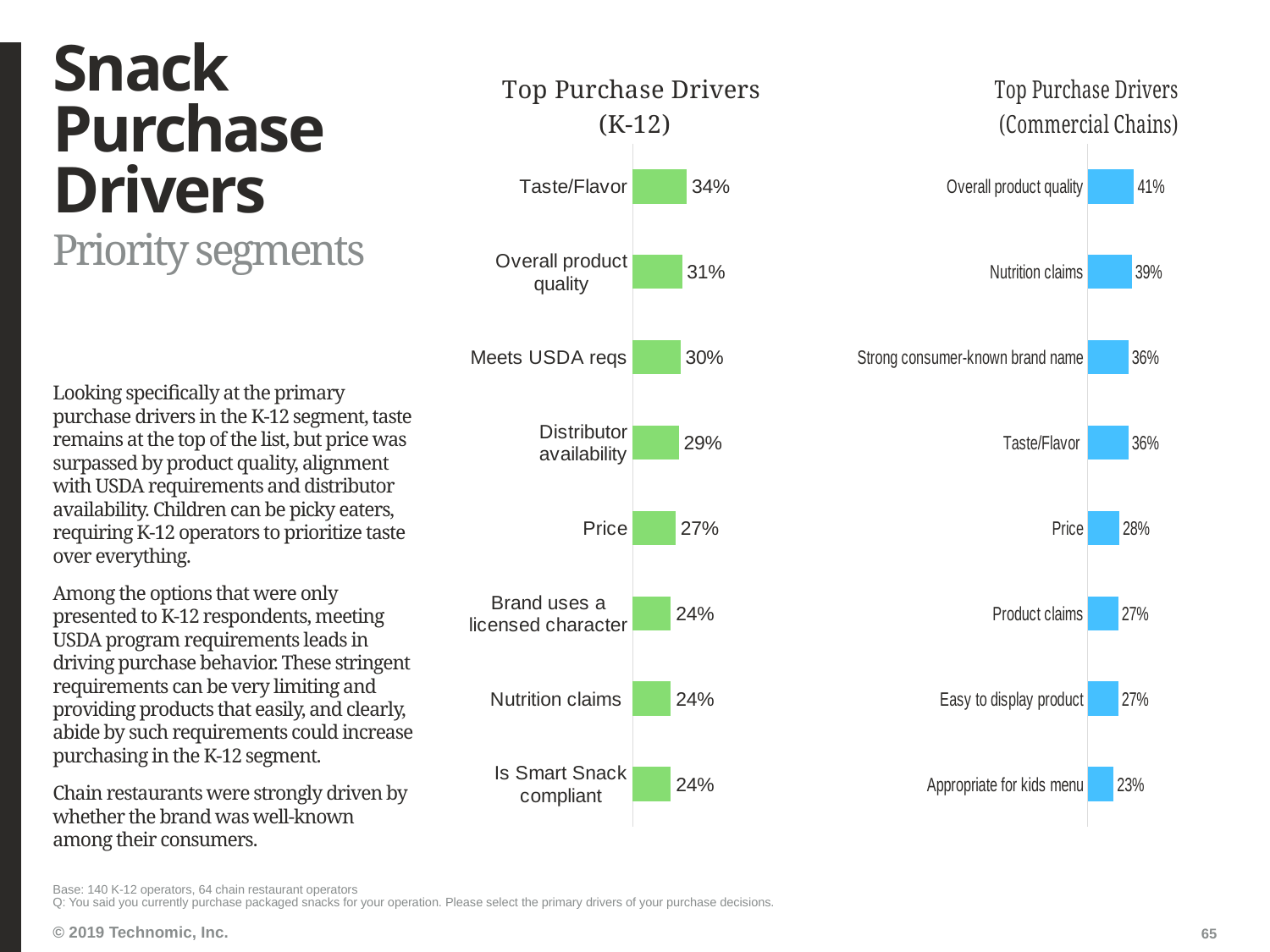
In the Top Purchase Drivers (Commercial Chains) chart, what is the value for Nutrition claims? 39% In the Top Purchase Drivers (K-12) chart, what is the difference between Taste/Flavor and Price? 7% In the Top Purchase Drivers (K-12) chart, which category has the highest value? Taste/Flavor In the Top Purchase Drivers (K-12) chart, which is larger: Overall product quality or Meets USDA reqs? Overall product quality In the Top Purchase Drivers (K-12) chart, what is the value for Taste/Flavor? 34% In the Top Purchase Drivers (Commercial Chains) chart, which category has the highest value? Overall product quality How many categories are shown in the Top Purchase Drivers (K-12) chart? 8 What type of chart is the Top Purchase Drivers (Commercial Chains) chart? Bar chart In the Top Purchase Drivers (Commercial Chains) chart, which category has the lowest value? Appropriate for kids menu In the Top Purchase Drivers (Commercial Chains) chart, what is the difference between Overall product quality and Price? 13% In the Top Purchase Drivers (K-12) chart, what is the value for Distributor availability? 29% What colour are the bars in the Top Purchase Drivers (K-12) chart? Green